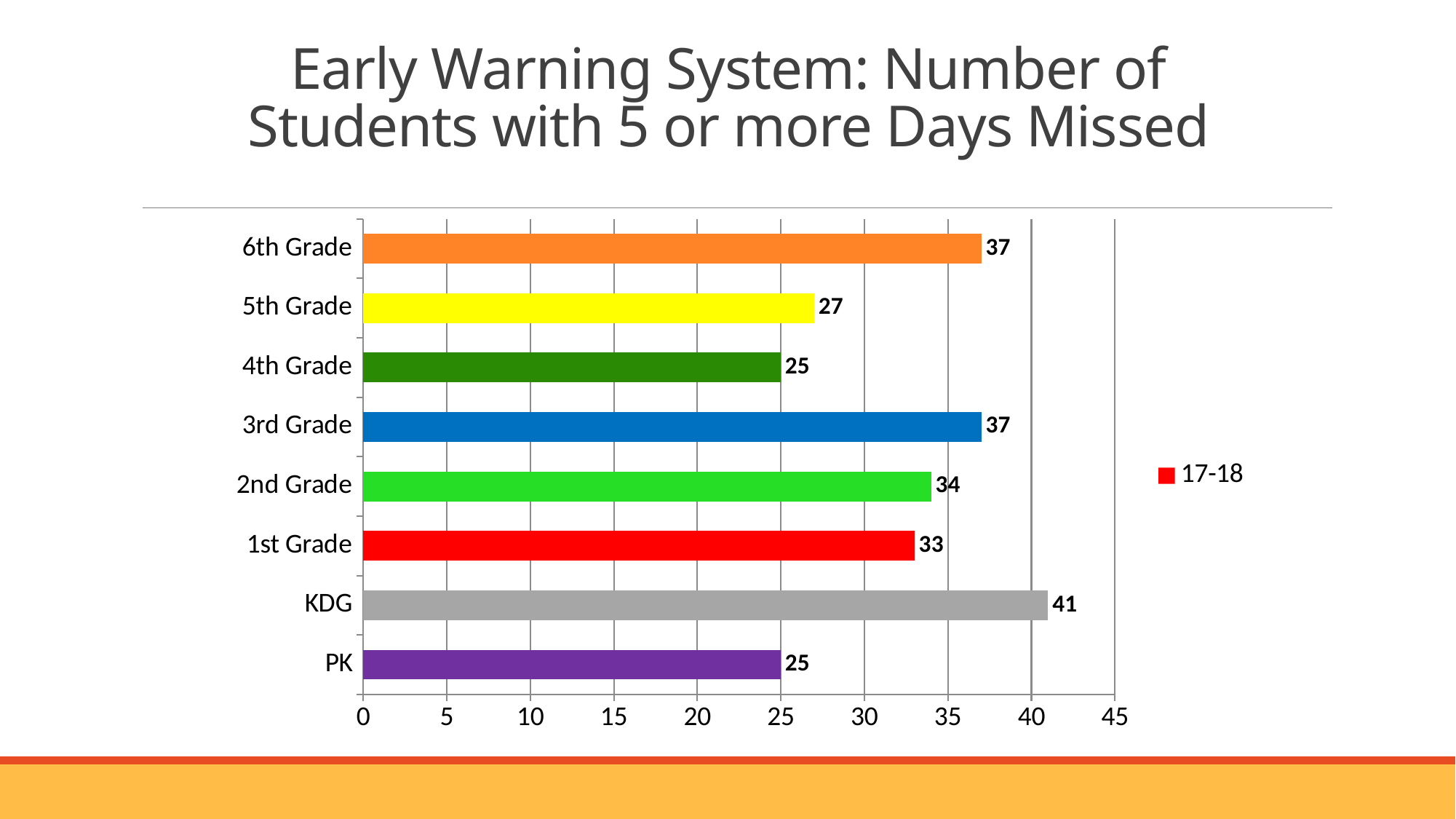
What series name is shown in the legend? 17-18 Which is larger, the value for 2nd Grade or the value for 5th Grade? 2nd Grade What is the difference between the values for 6th Grade and 4th Grade? 12 What is the number of students with 5 or more days missed in KDG? 41 Is the value for 3rd Grade greater or less than 30? greater What is the difference between the values for KDG and 1st Grade? 8 Which grade has the highest number of students with 5 or more days missed? KDG How many grade categories are shown in the chart? 8 How many series does the legend list? 1 What kind of chart is shown on the slide? Bar chart What is the value for 5th Grade? 27 What is the value for 2nd Grade? 34